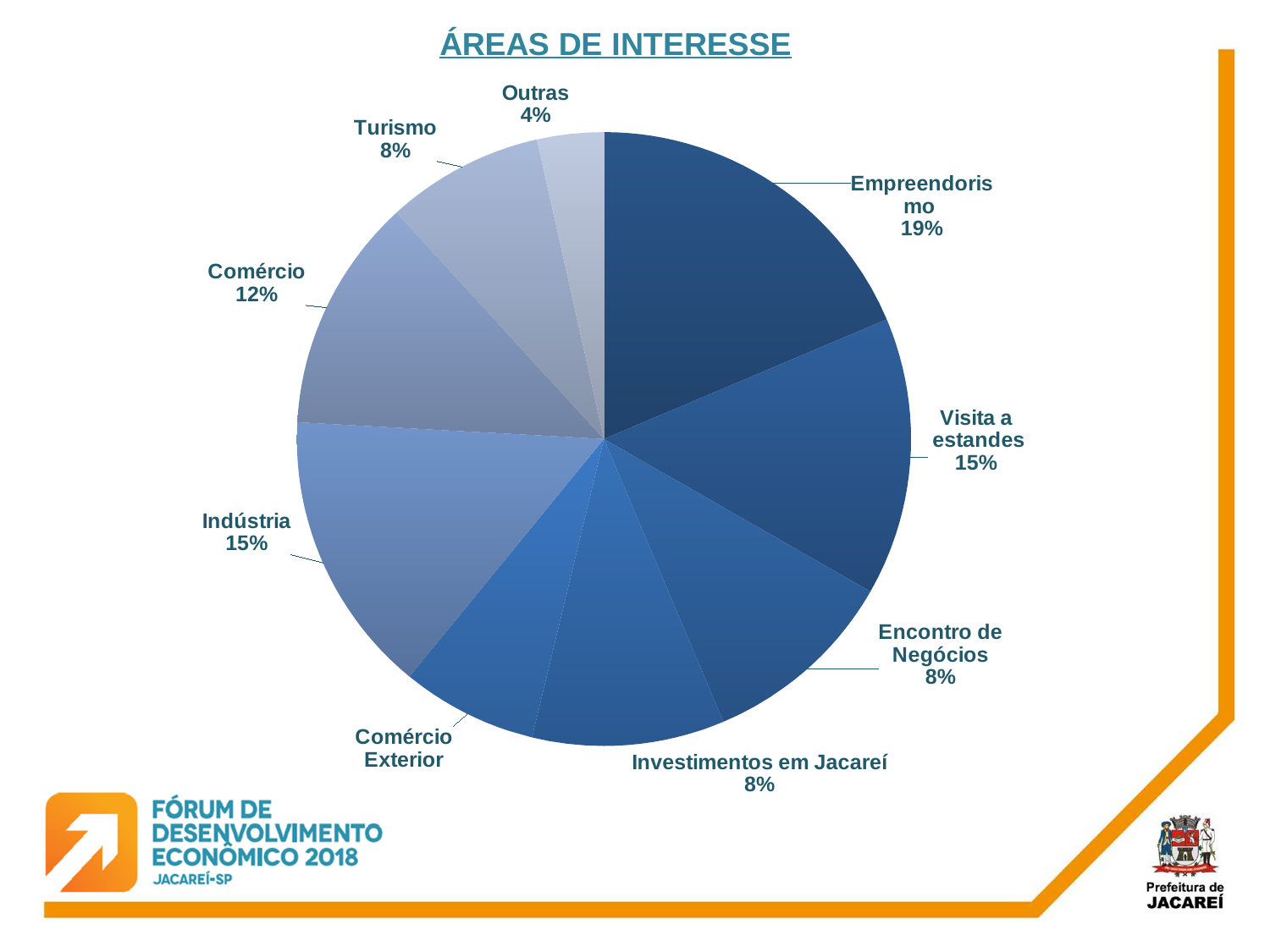
What is the difference in percentage points between Empreendorismo and Indústria? 4 What type of chart is shown on the slide? Pie chart Which category has the largest slice of the pie? Empreendorismo What percentage is shown for Visita a estandes? 15% What percentage is shown for Outras? 4% How many slices does the pie chart have? 9 Which is larger, the share for Comércio or the share for Encontro de Negócios? Comércio What percentage is shown for Turismo? 8% Which category has the smallest slice of the pie? Outras What percentage is shown for Comércio? 12% What share of the pie does Empreendorismo represent? 19% What is the title of the chart? ÁREAS DE INTERESSE